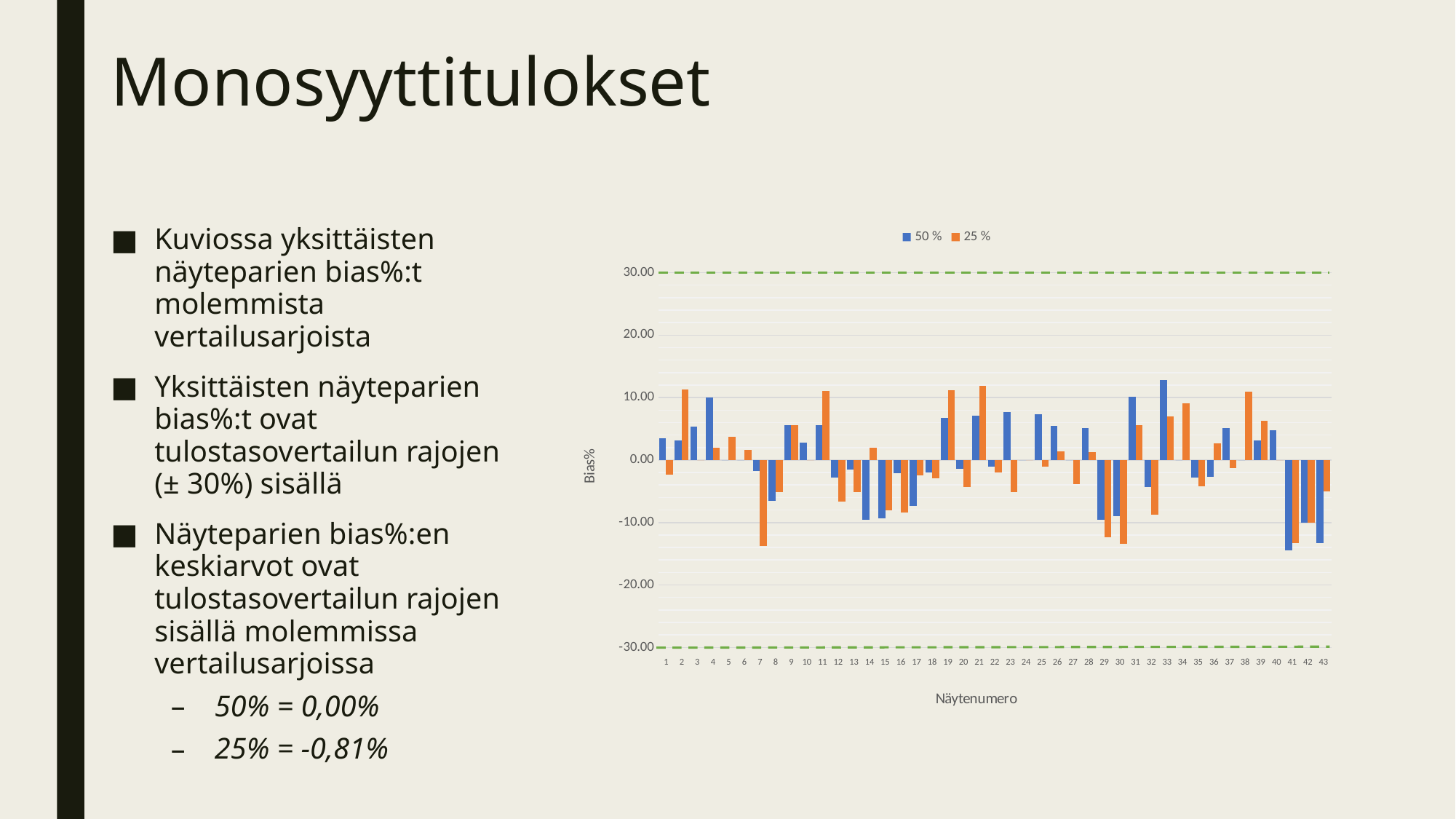
Which sample number has the highest value in the 50 % series? 33 Is the value of the 50 % series for sample 33 greater or less than 10.00? greater Is the value of the 25 % series for sample 30 greater or less than -10.00? less Is the value of the 25 % series for sample 21 greater or less than 10.00? greater How many series does the chart legend list? 2 For sample 4, which series has the larger value, 50 % or 25 %? 50 % How many sample numbers (categories) are shown on the x axis of the chart? 43 What kind of chart is shown on the slide? bar chart What are the two series named in the chart legend? 50 % and 25 % What is the title of the x axis of the chart? Näytenumero